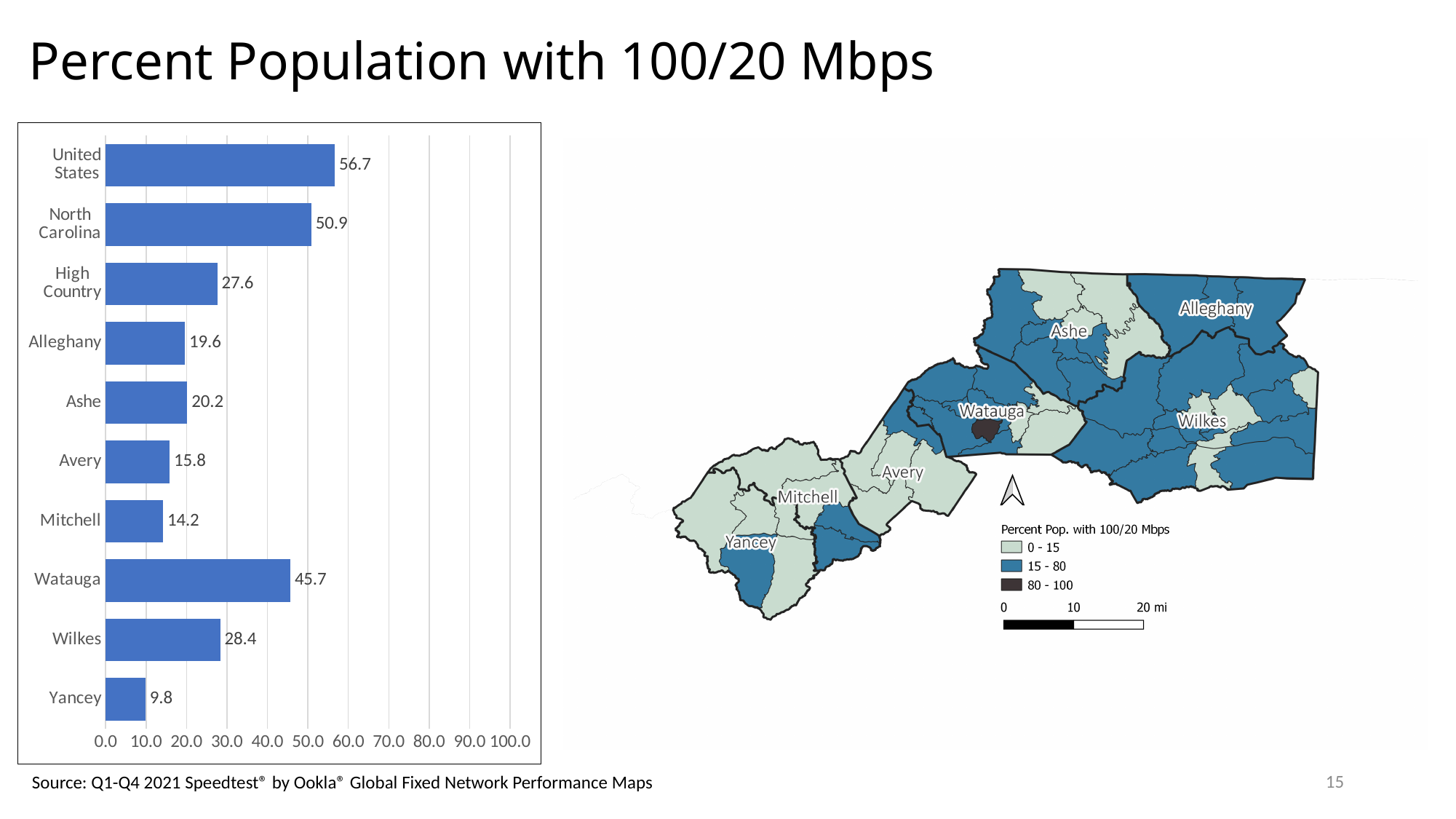
What is the value for Watauga in the bar chart? 45.7 What is the value for High Country in the bar chart? 27.6 What is the value for Yancey in the bar chart? 9.8 What is the difference between the values for United States and North Carolina in the bar chart? 5.8 How many categories are shown in the bar chart? 10 What is the maximum value shown on the x axis of the bar chart? 100.0 Which has a larger value in the bar chart, Wilkes or Alleghany? Wilkes Which category has the lowest value in the bar chart? Yancey What kind of chart is shown on the left of the slide? Bar chart Which category has the highest value in the bar chart? United States Which has a larger value in the bar chart, Ashe or Avery? Ashe What is the difference between the values for Watauga and Mitchell in the bar chart? 31.5